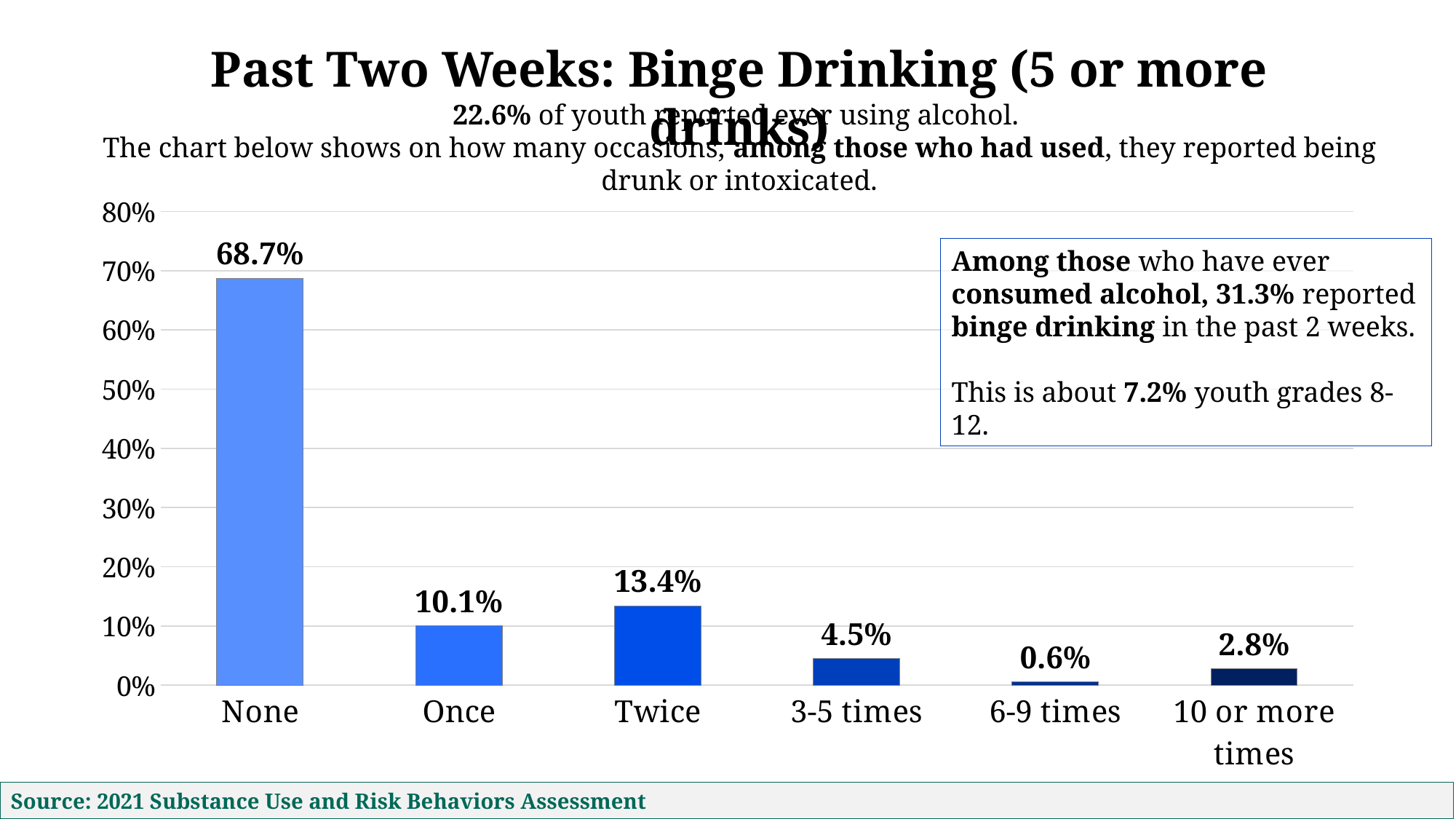
What is the value for "6-9 times"? 0.6% Which category has the highest value? None What is the value for "Twice"? 13.4% What kind of chart is shown on the slide? Bar chart What is the difference between the values for "Twice" and "Once"? 3.3% Is the value for "None" greater or less than 60%? greater Which is larger, the value for "3-5 times" or the value for "10 or more times"? 3-5 times What is the value for "10 or more times"? 2.8% How many categories are shown on the x axis? 6 What is the value for the "None" category? 68.7% Which category has the lowest value? 6-9 times What is the source cited at the bottom of the slide? 2021 Substance Use and Risk Behaviors Assessment